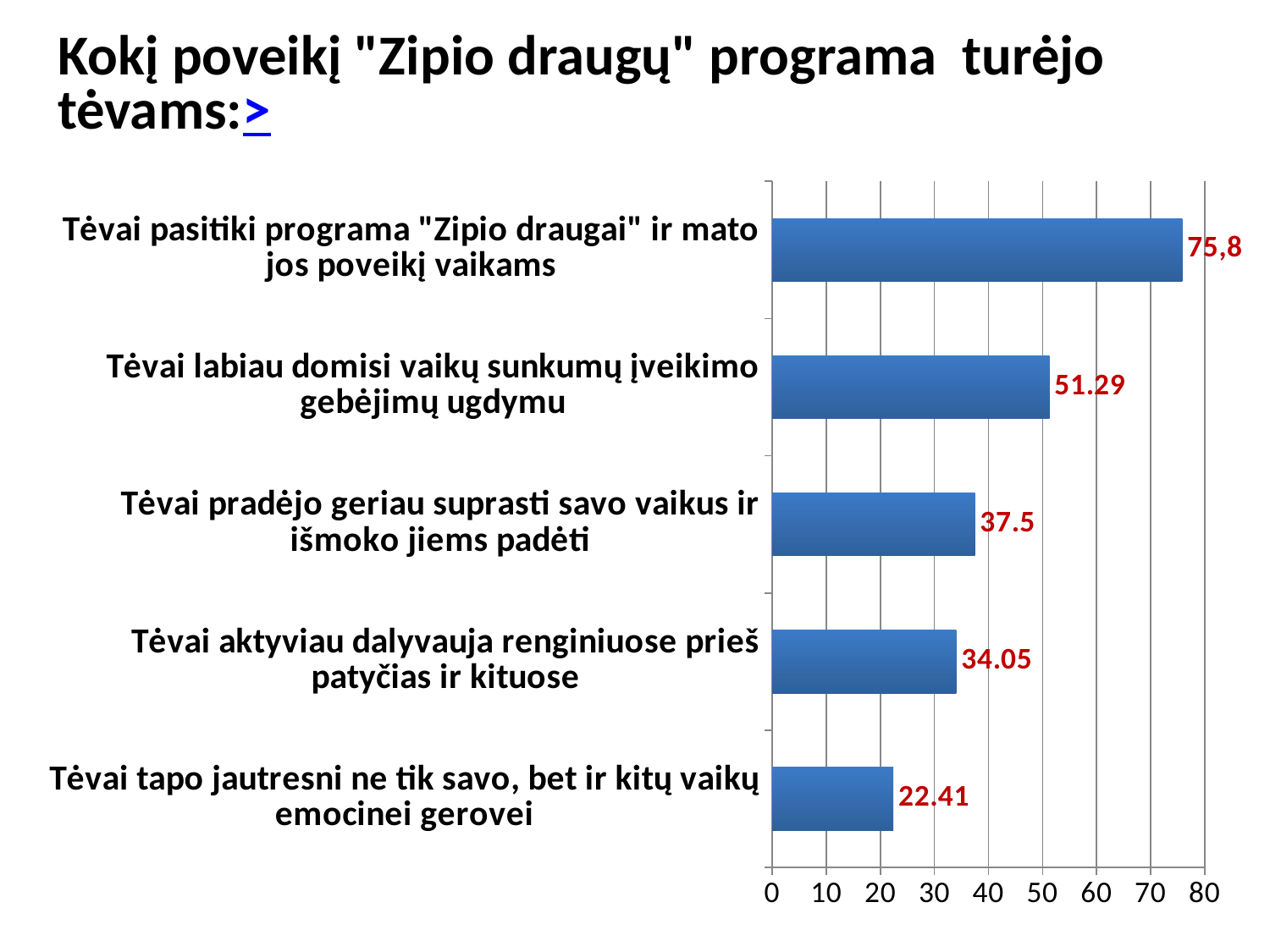
Which is larger: the value for "Tėvai pradėjo geriau suprasti savo vaikus ir išmoko jiems padėti" or for "Tėvai aktyviau dalyvauja renginiuose prieš patyčias ir kituose"? Tėvai pradėjo geriau suprasti savo vaikus ir išmoko jiems padėti Which category has the highest value? Tėvai pasitiki programa "Zipio draugai" ir mato jos poveikį vaikams Which category has the lowest value? Tėvai tapo jautresni ne tik savo, bet ir kitų vaikų emocinei gerovei How many categories are shown in the chart? 5 What is the value for "Tėvai pradėjo geriau suprasti savo vaikus ir išmoko jiems padėti"? 37.5 What is the value for "Tėvai labiau domisi vaikų sunkumų įveikimo gebėjimų ugdymu"? 51.29 What is the value for "Tėvai pasitiki programa "Zipio draugai" ir mato jos poveikį vaikams"? 75,8 What is the value for "Tėvai tapo jautresni ne tik savo, bet ir kitų vaikų emocinei gerovei"? 22.41 What kind of chart is shown on the slide? Bar chart What is the difference between the values for "Tėvai labiau domisi vaikų sunkumų įveikimo gebėjimų ugdymu" and "Tėvai pradėjo geriau suprasti savo vaikus ir išmoko jiems padėti"? 13.79 What is the difference between the values for "Tėvai aktyviau dalyvauja renginiuose prieš patyčias ir kituose" and "Tėvai tapo jautresni ne tik savo, bet ir kitų vaikų emocinei gerovei"? 11.64 What is the value for "Tėvai aktyviau dalyvauja renginiuose prieš patyčias ir kituose"? 34.05